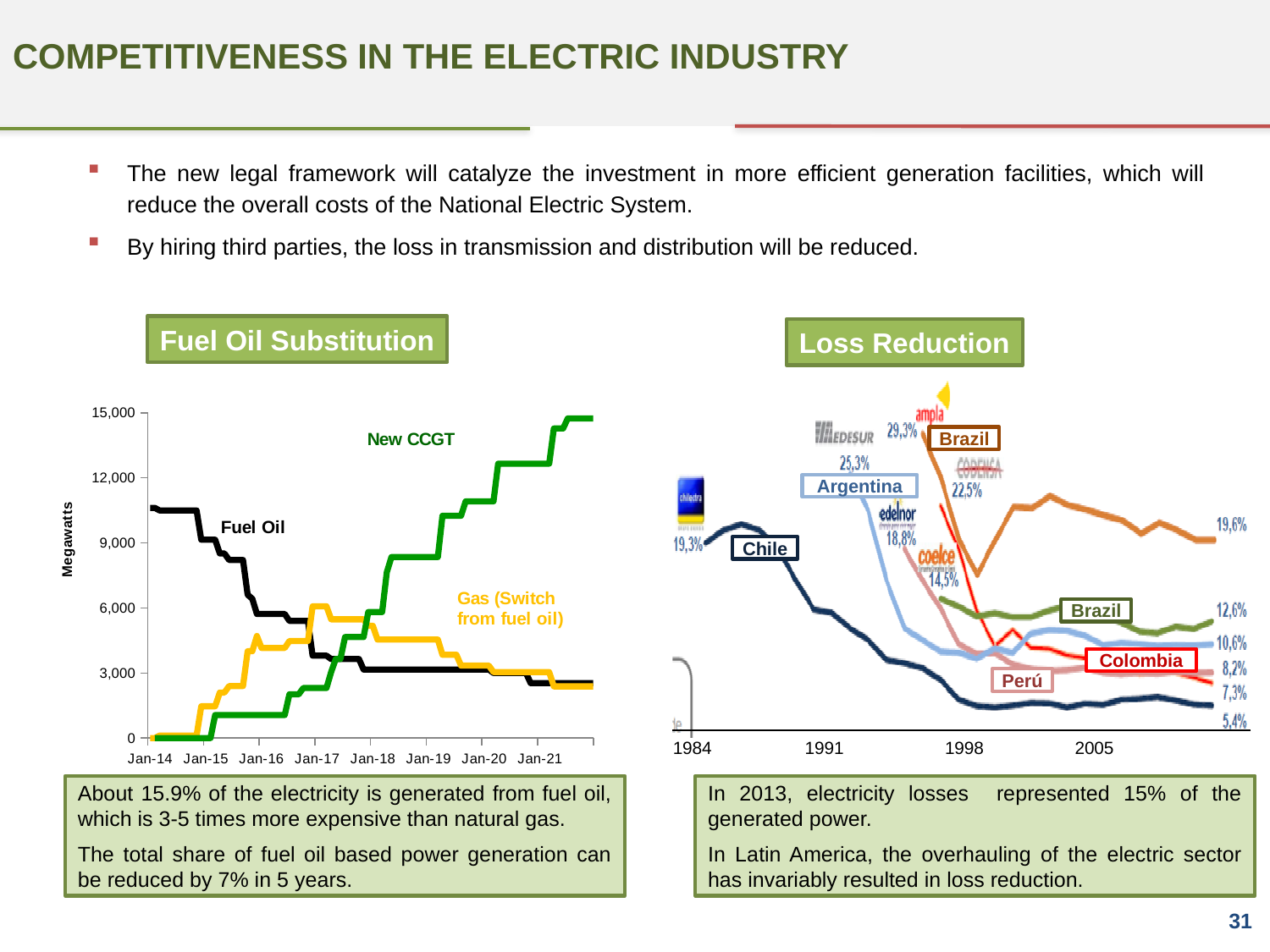
On the Loss Reduction chart, what loss percentage is labelled for Argentina at the start of its line? 25,3% What type of chart is the Fuel Oil Substitution chart? line chart On the Fuel Oil Substitution chart, does the New CCGT series rise or fall from Jan-14 to Jan-21? rise On the Loss Reduction chart, what is the first year shown on the x-axis? 1984 What unit is shown on the y-axis of the Fuel Oil Substitution chart? Megawatts On the Fuel Oil Substitution chart, which series is higher at Jan-21, New CCGT or Fuel Oil? New CCGT On the Fuel Oil Substitution chart, is the Fuel Oil value at Jan-14 greater or less than 9,000? greater On the Loss Reduction chart, what loss percentage is labelled for Chile at the start of its line? 19,3% On the Fuel Oil Substitution chart, does the Fuel Oil series rise or fall from Jan-14 to Jan-21? fall How many series are plotted on the Fuel Oil Substitution chart? 3 On the Loss Reduction chart, which country's line ends at the lowest value? Chile On the Fuel Oil Substitution chart, is the New CCGT value at Jan-21 greater or less than 12,000? greater